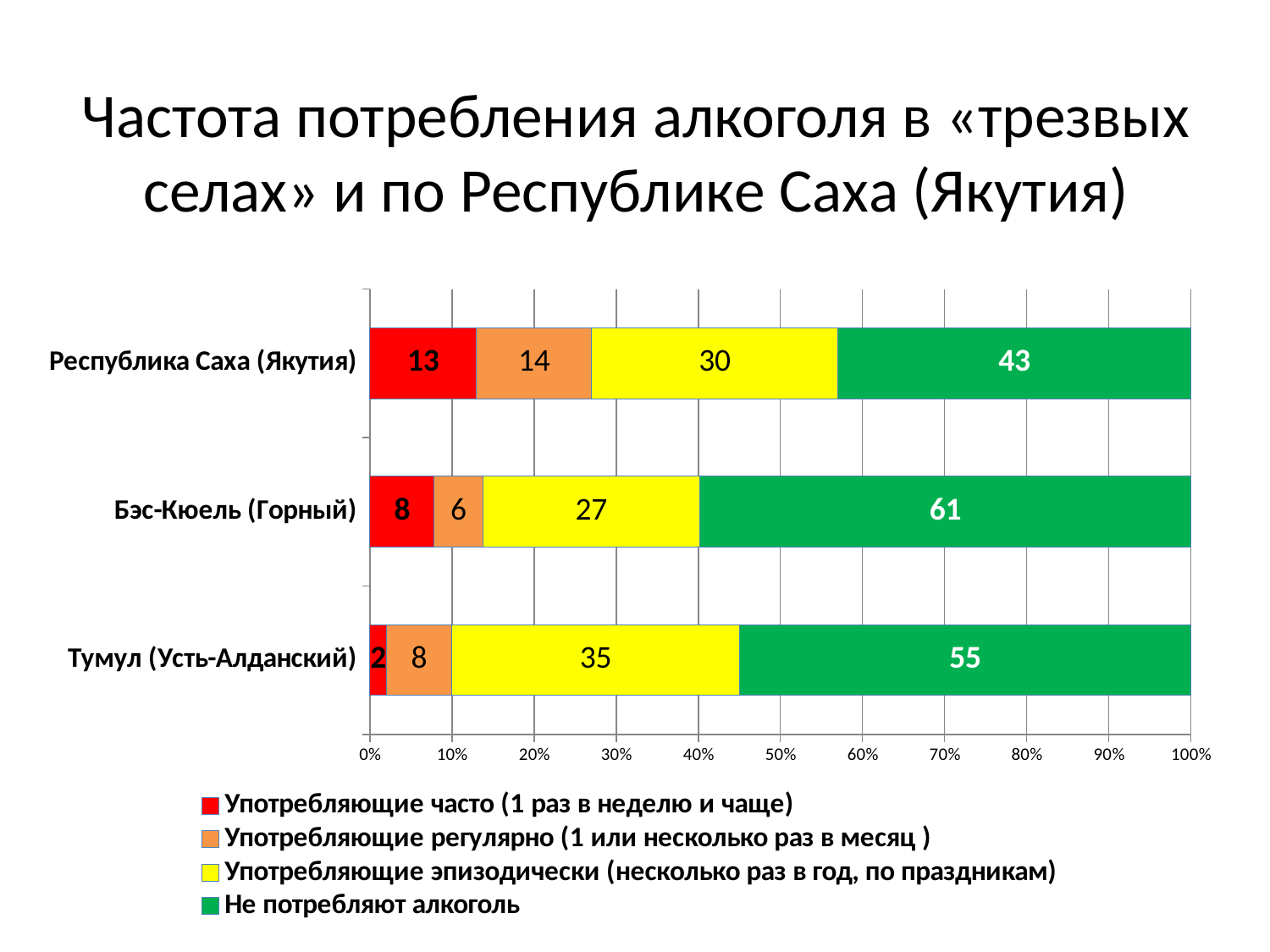
What kind of chart is shown on the slide? Stacked bar chart How many series does the legend list? 4 Which category has the highest value for "Не потребляют алкоголь"? Бэс-Кюель (Горный) What is the value of "Употребляющие регулярно" for Бэс-Кюель (Горный)? 6 Which is larger: the "Употребляющие регулярно" value for Республика Саха (Якутия) or for Тумул (Усть-Алданский)? Республика Саха (Якутия) How many categories (regions/villages) are shown on the chart? 3 What is the value of "Употребляющие эпизодически" for Тумул (Усть-Алданский)? 35 What is the difference between the "Не потребляют алкоголь" values for Бэс-Кюель (Горный) and Республика Саха (Якутия)? 18 What colour represents "Не потребляют алкоголь" in the chart? Green What is the value of "Употребляющие часто (1 раз в неделю и чаще)" for Республика Саха (Якутия)? 13 What is the value of "Не потребляют алкоголь" for Бэс-Кюель (Горный)? 61 Which category has the lowest value for "Употребляющие часто (1 раз в неделю и чаще)"? Тумул (Усть-Алданский)